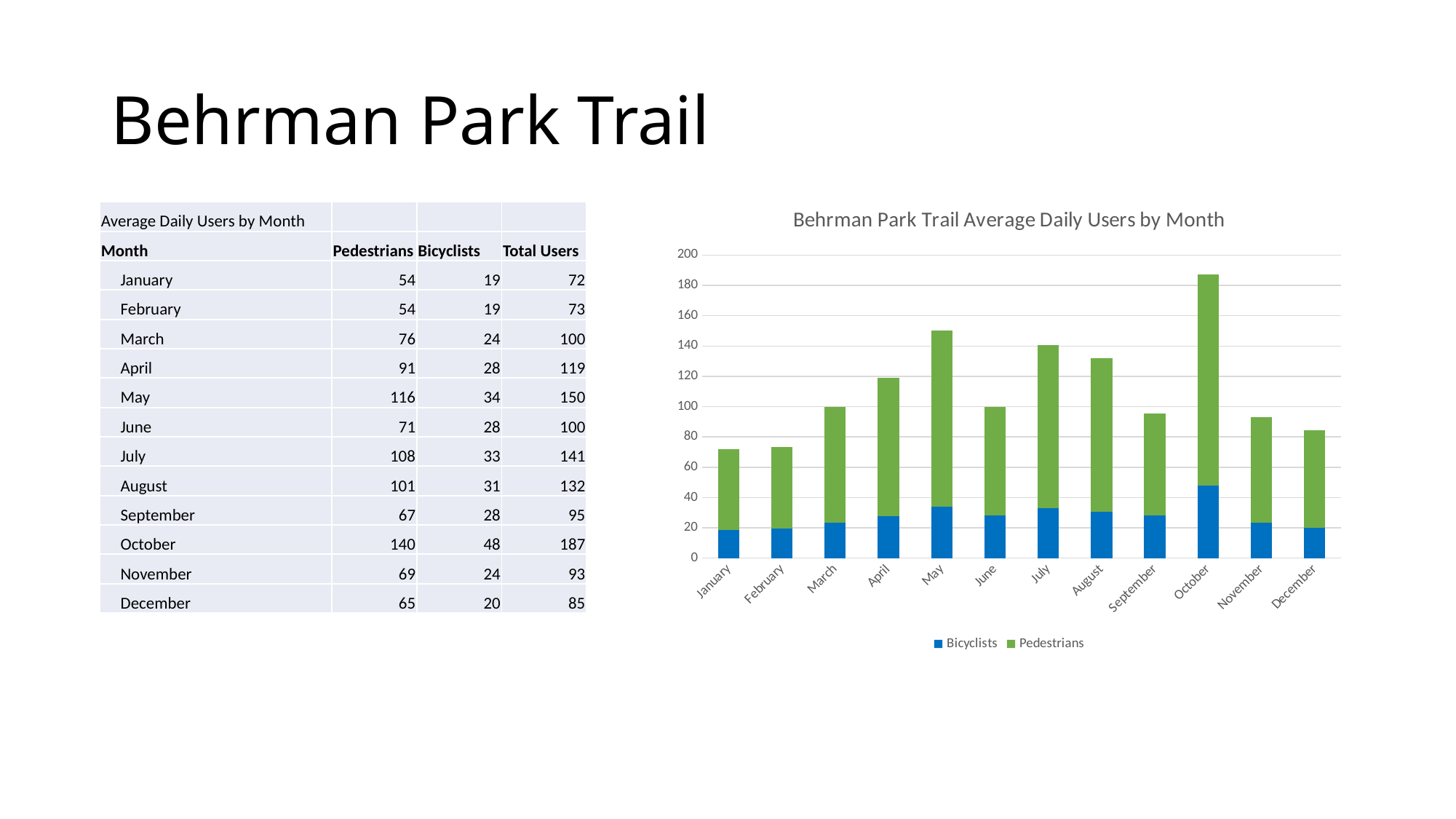
Is the total bar for December greater or less than 100? less What is the Pedestrians value for August? 101 Which month has the lowest total bar in the chart? January What is the difference between the Pedestrians values for October and November? 71 Is the total bar for July greater or less than 120? greater What kind of chart is shown on the slide? stacked bar chart What is the Bicyclists value for May? 34 Which month has the highest total bar in the chart? October Which is larger, the total bar for May or the total bar for August? May What is the total number of average daily users for October? 187 How many series does the chart legend list? 2 How many months are plotted along the x axis of the chart? 12